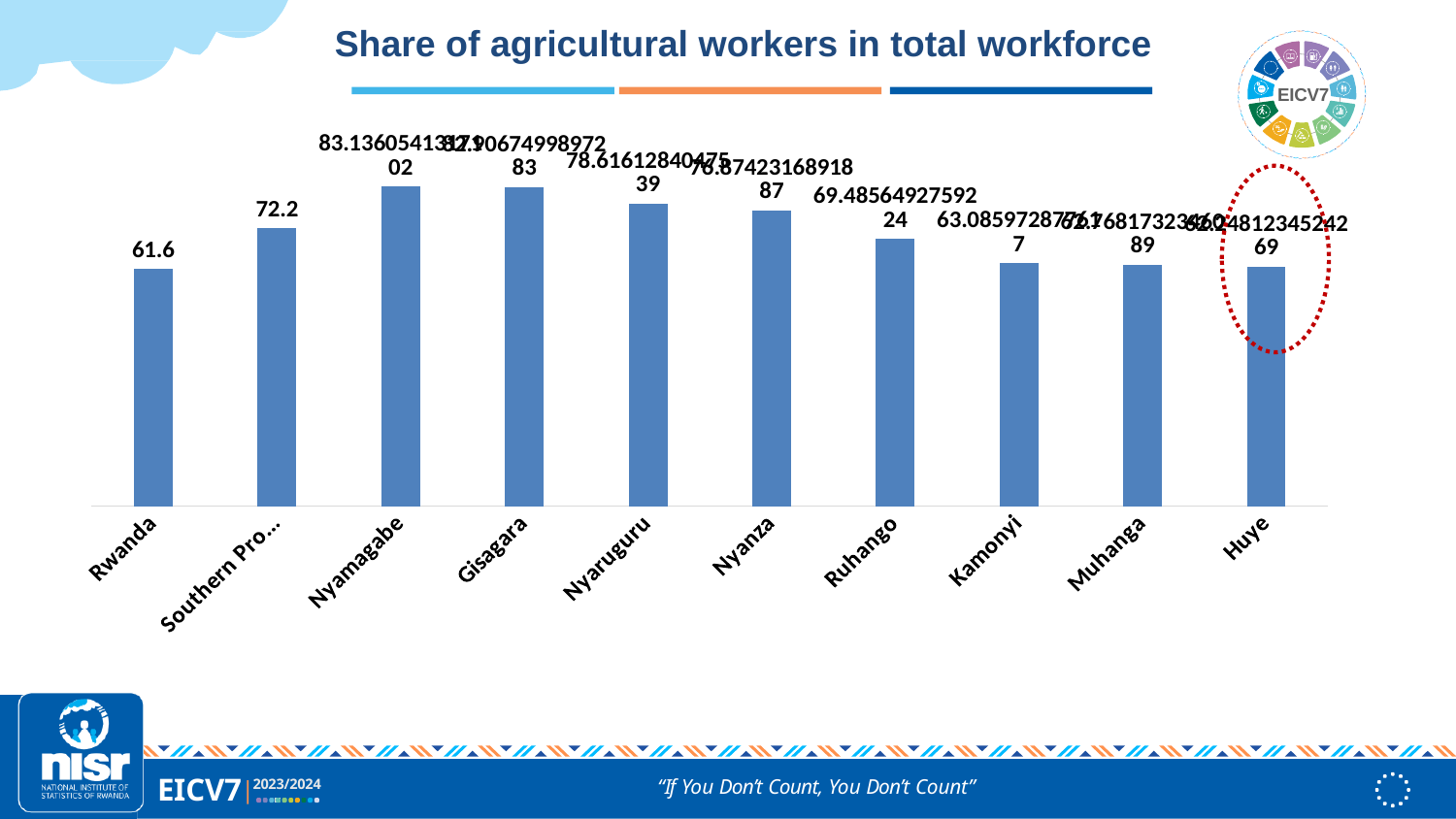
What is the title of the chart? Share of agricultural workers in total workforce Which is larger, the value for Nyamagabe or the value for Rwanda? Nyamagabe What is the value for Southern Pro...? 72.2 Which is larger, the value for Nyaruguru or the value for Ruhango? Nyaruguru Which is larger, the value for Southern Pro... or the value for Kamonyi? Southern Pro... What is the value for Rwanda? 61.6 Which category's bar is highlighted with a red dotted circle? Huye How many categories are shown on the x axis? 10 What kind of chart is shown on the slide? Bar chart What is the difference between the values for Southern Pro... and Rwanda? 10.6 Moving along the x axis from Nyamagabe to Huye, do the values rise or fall? Fall